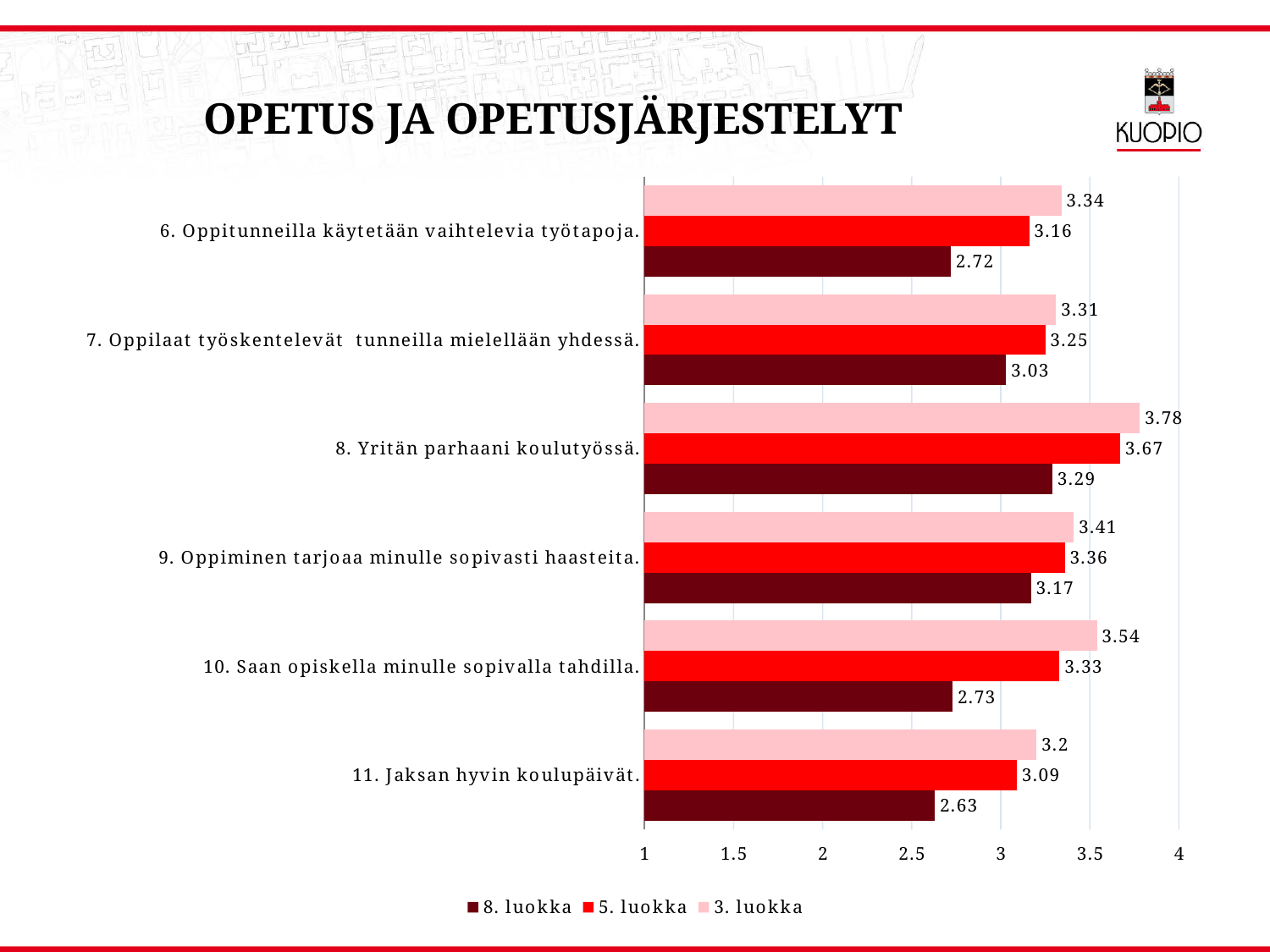
What is the value for 3. luokka on "8. Yritän parhaani koulutyössä."? 3.78 Which category has the highest value for 8. luokka? 8. Yritän parhaani koulutyössä. What is the value for 5. luokka on "10. Saan opiskella minulle sopivalla tahdilla."? 3.33 Is the value for 8. luokka on "6. Oppitunneilla käytetään vaihtelevia työtapoja." greater or less than 3? less How many categories (statements) are shown on the chart? 6 What is the title of the slide? OPETUS JA OPETUSJÄRJESTELYT How many series does the legend list? 3 For "7. Oppilaat työskentelevät tunneilla mielellään yhdessä.", which is larger: the 5. luokka value or the 8. luokka value? 5. luokka What is the difference between the 3. luokka and 8. luokka values for "10. Saan opiskella minulle sopivalla tahdilla."? 0.81 What kind of chart is shown on the slide? Bar chart What is the value for 8. luokka on "11. Jaksan hyvin koulupäivät."? 2.63 Which category has the lowest value for 3. luokka? 11. Jaksan hyvin koulupäivät.